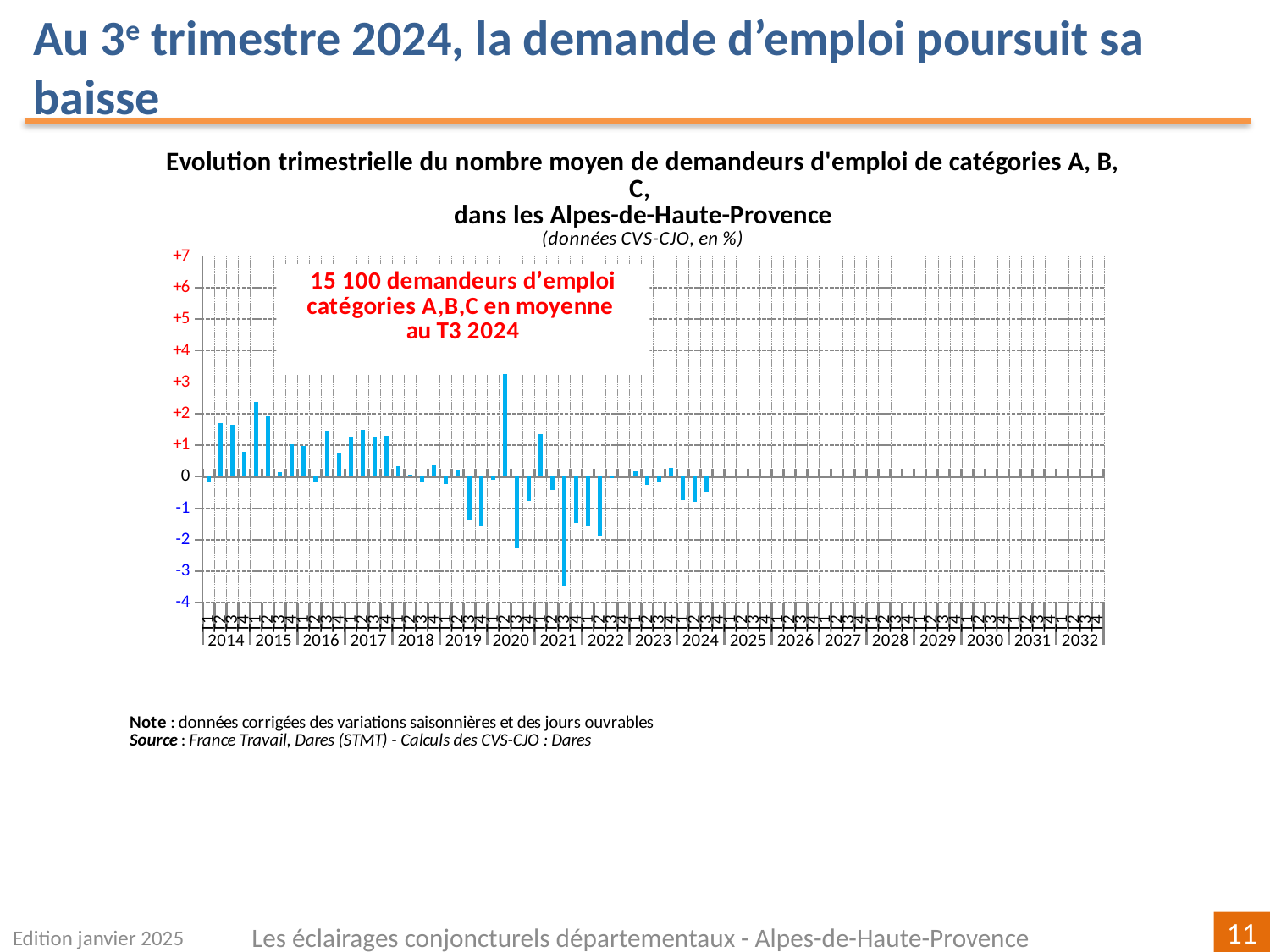
In which year does the chart's lowest bar occur? 2021 What is the first year labelled on the x axis of the chart? 2014 What kind of chart is shown on the slide? Bar chart Is the value of the highest bar (in 2020) greater or less than +2? greater In which year does the chart's highest bar occur? 2020 Which is larger: the highest bar in 2020 or the highest bar in 2015? 2020 Is the value of the lowest bar (in 2021) greater or less than -2? less What is the highest value shown on the chart's vertical axis? +7 How many years are labelled along the x axis of the chart? 19 Which is lower: the lowest bar in 2021 or the lowest bar in 2019? 2021